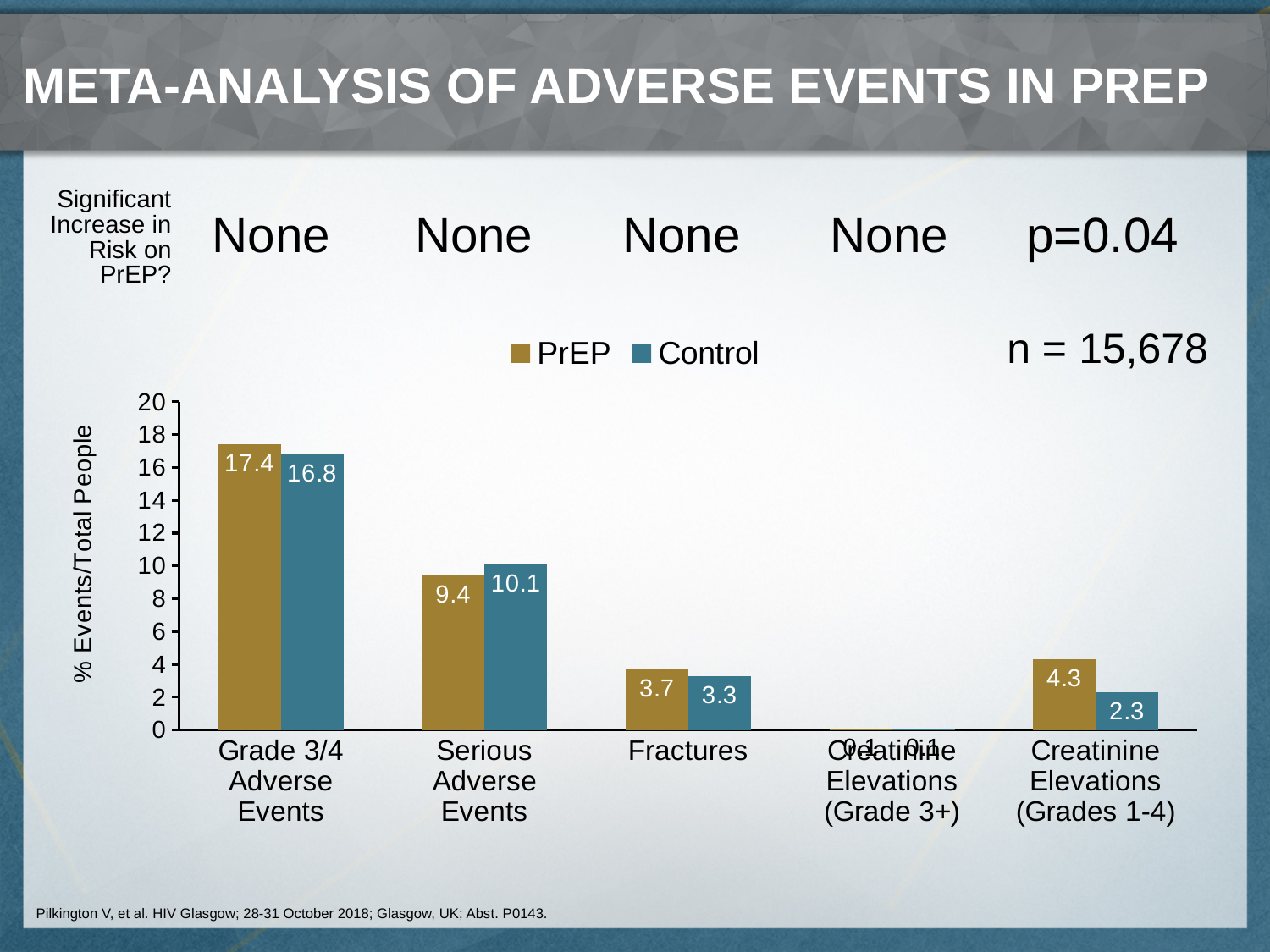
What kind of chart is shown on the slide? Bar chart Is the Control value for Grade 3/4 Adverse Events greater or less than 10? greater Which category has the highest PrEP value? Grade 3/4 Adverse Events What is the Control value for Fractures? 3.3 What is the PrEP value for Grade 3/4 Adverse Events? 17.4 How many categories are shown on the x axis? 5 How many series does the legend list? 2 What is the Control value for Serious Adverse Events? 10.1 What is the difference between the Control and PrEP values for Serious Adverse Events? 0.7 For Serious Adverse Events, which is larger: the PrEP value or the Control value? Control What is the difference between the PrEP and Control values for Creatinine Elevations (Grades 1-4)? 2.0 What is the PrEP value for Creatinine Elevations (Grades 1-4)? 4.3